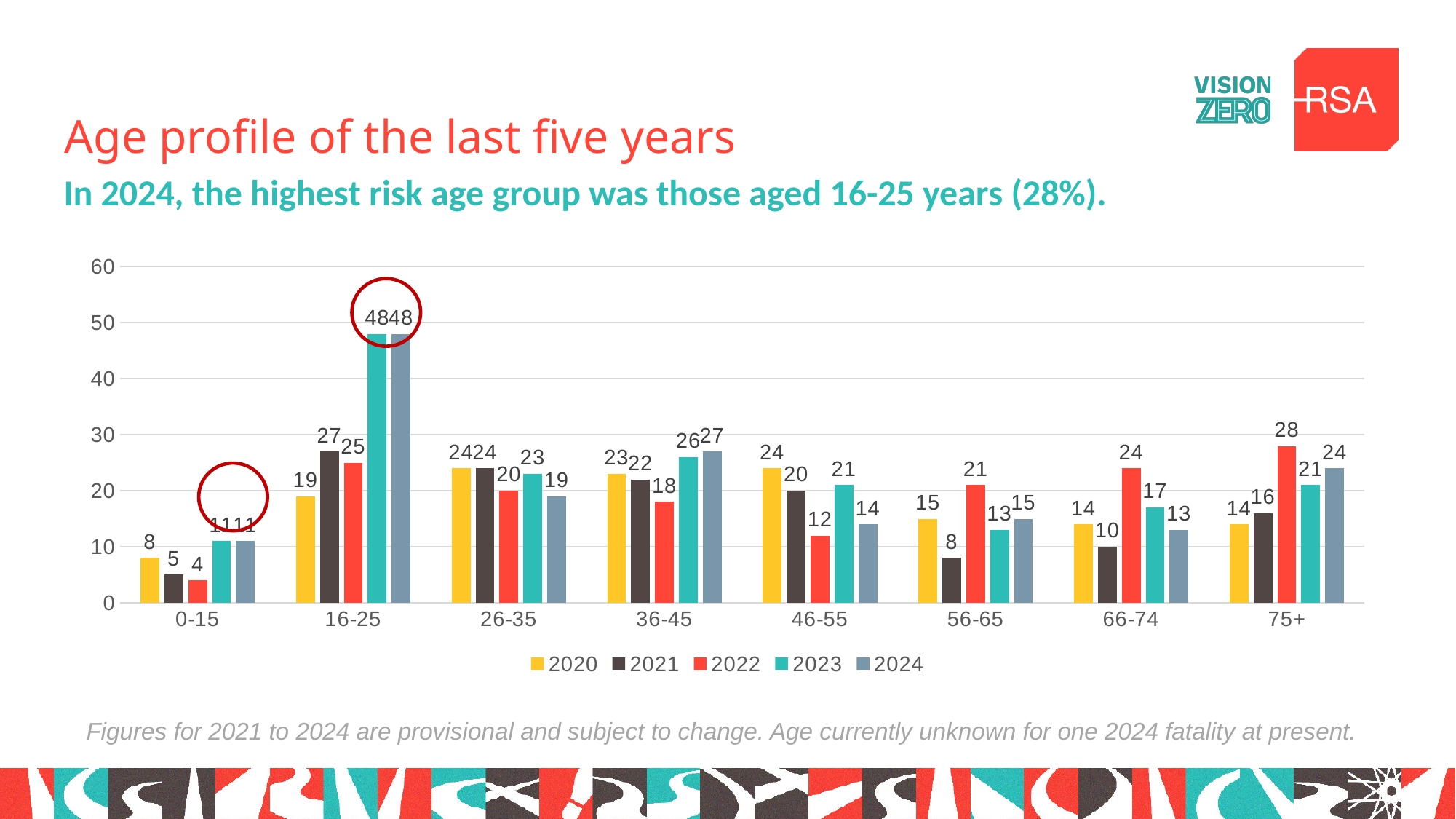
How many series does the legend list? 5 What is the difference between the 2022 and 2021 values in the 46-55 age group? 8 Which year does the red series in the legend represent? 2022 How many age groups are shown on the x axis? 8 Which is larger in the 66-74 age group: the 2022 value or the 2023 value? 2022 What is the value for the 2024 series in the 16-25 age group? 48 What is the value for the 2021 series in the 56-65 age group? 8 What kind of chart is shown on the slide? Bar chart What is the value for the 2022 series in the 75+ age group? 28 What is the difference between the 2024 and 2020 values in the 16-25 age group? 29 Which age group has the highest value for the 2023 series? 16-25 Which age group has the lowest value for the 2022 series? 0-15